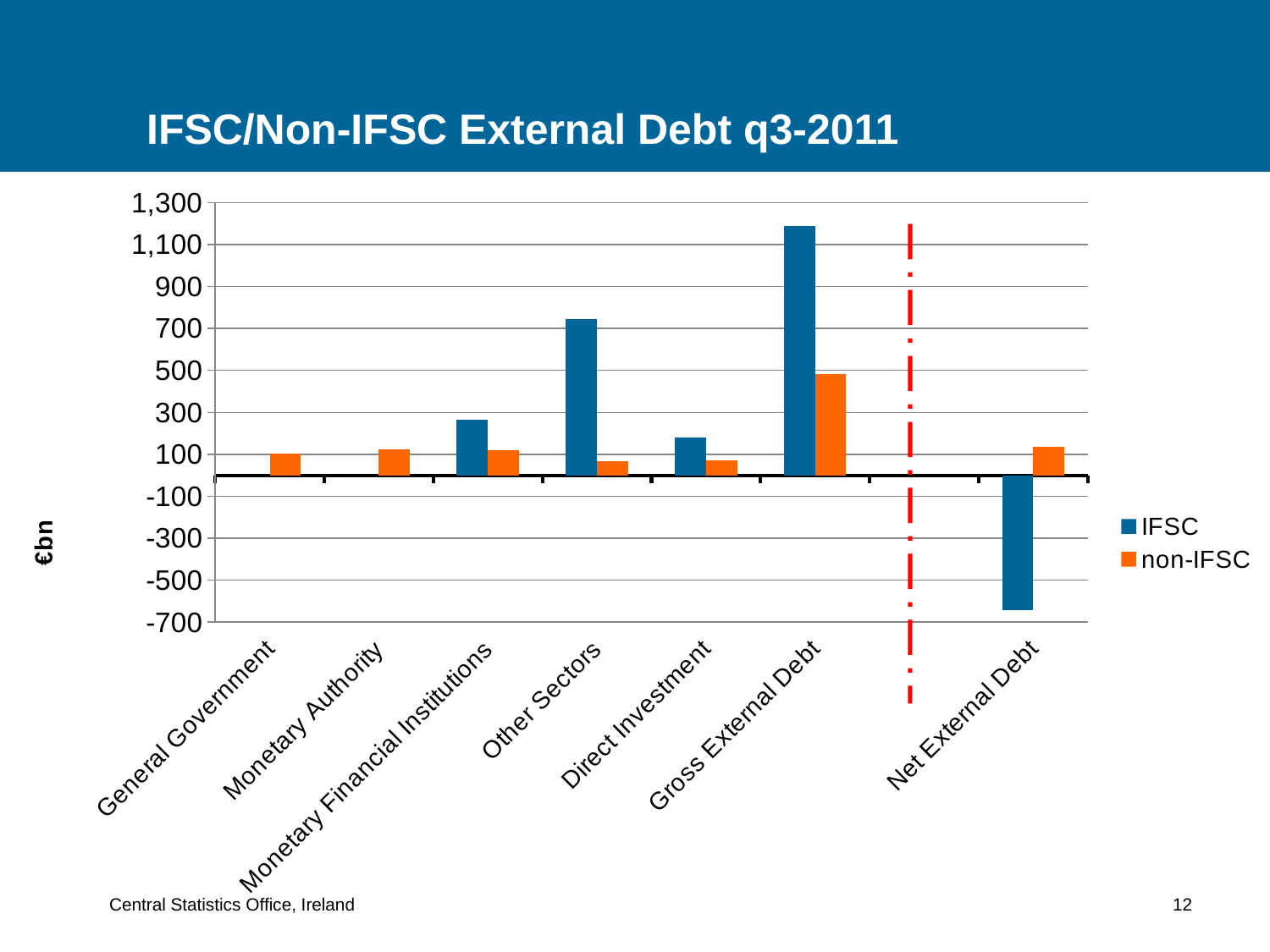
Which category has the lowest IFSC value? Net External Debt Is the IFSC value for Other Sectors greater or less than 500? greater Is the IFSC value for Net External Debt greater or less than -500? less How many series does the legend list? 2 Which category has the highest IFSC value? Gross External Debt What unit is shown on the y-axis label? €bn Which category has the highest non-IFSC value? Gross External Debt What kind of chart is shown on the slide? bar chart How many categories are shown along the x axis? 7 Is the non-IFSC value for Gross External Debt greater or less than 300? greater For Other Sectors, which is larger: the IFSC value or the non-IFSC value? IFSC